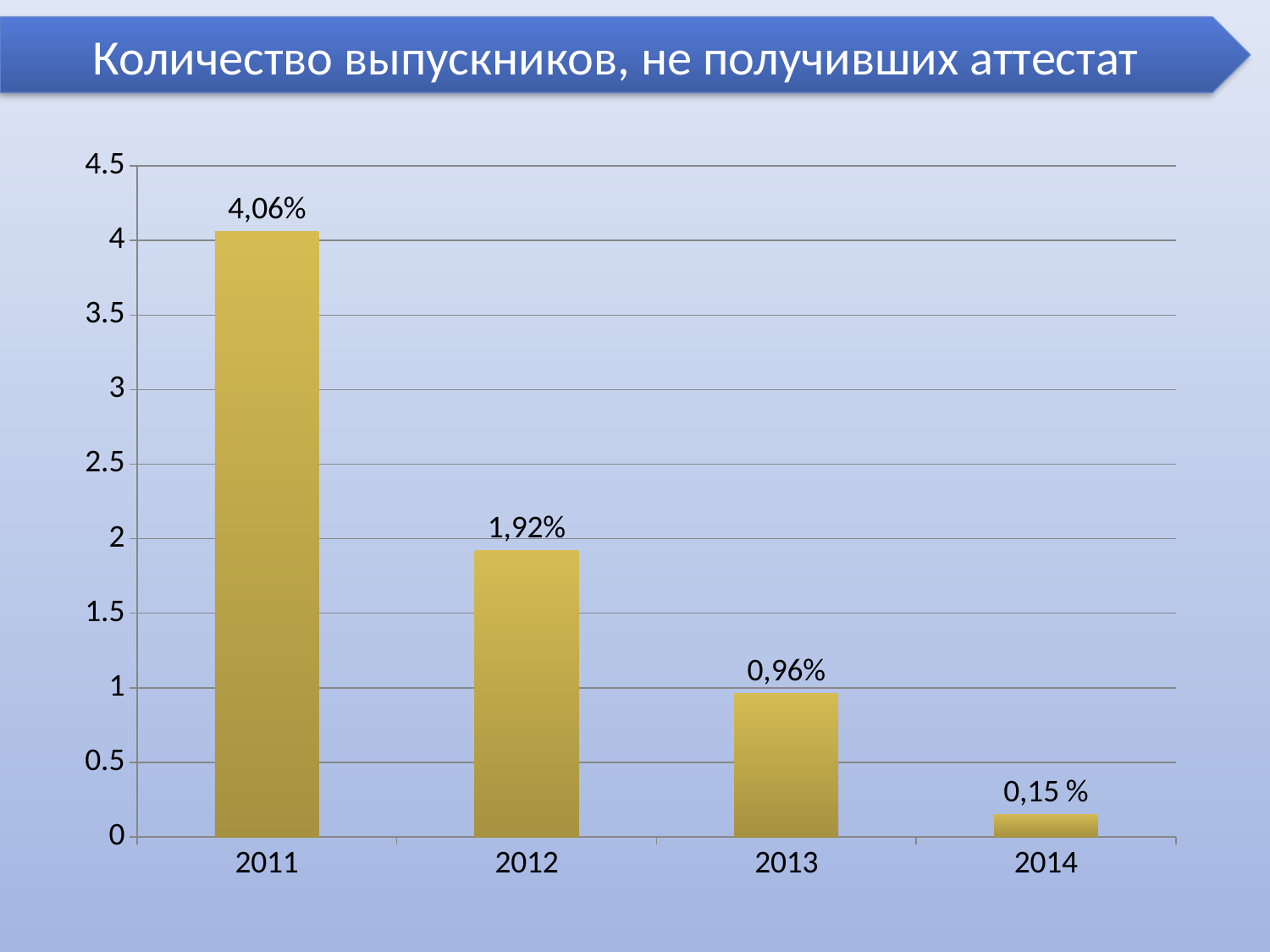
What is the value for 2011? 4,06% How many years are shown on the x axis? 4 Which is larger, the value for 2012 or the value for 2013? 2012 Which year has the lowest value? 2014 Do the values rise or fall from 2011 to 2014? fall Is the value for 2011 greater or less than 4? greater What is the value for 2013? 0,96% What kind of chart is shown on the slide? bar chart What is the value for 2014? 0,15 % Which year has the highest value? 2011 What is the value for 2012? 1,92% What is the difference between the values for 2011 and 2012? 2,14%